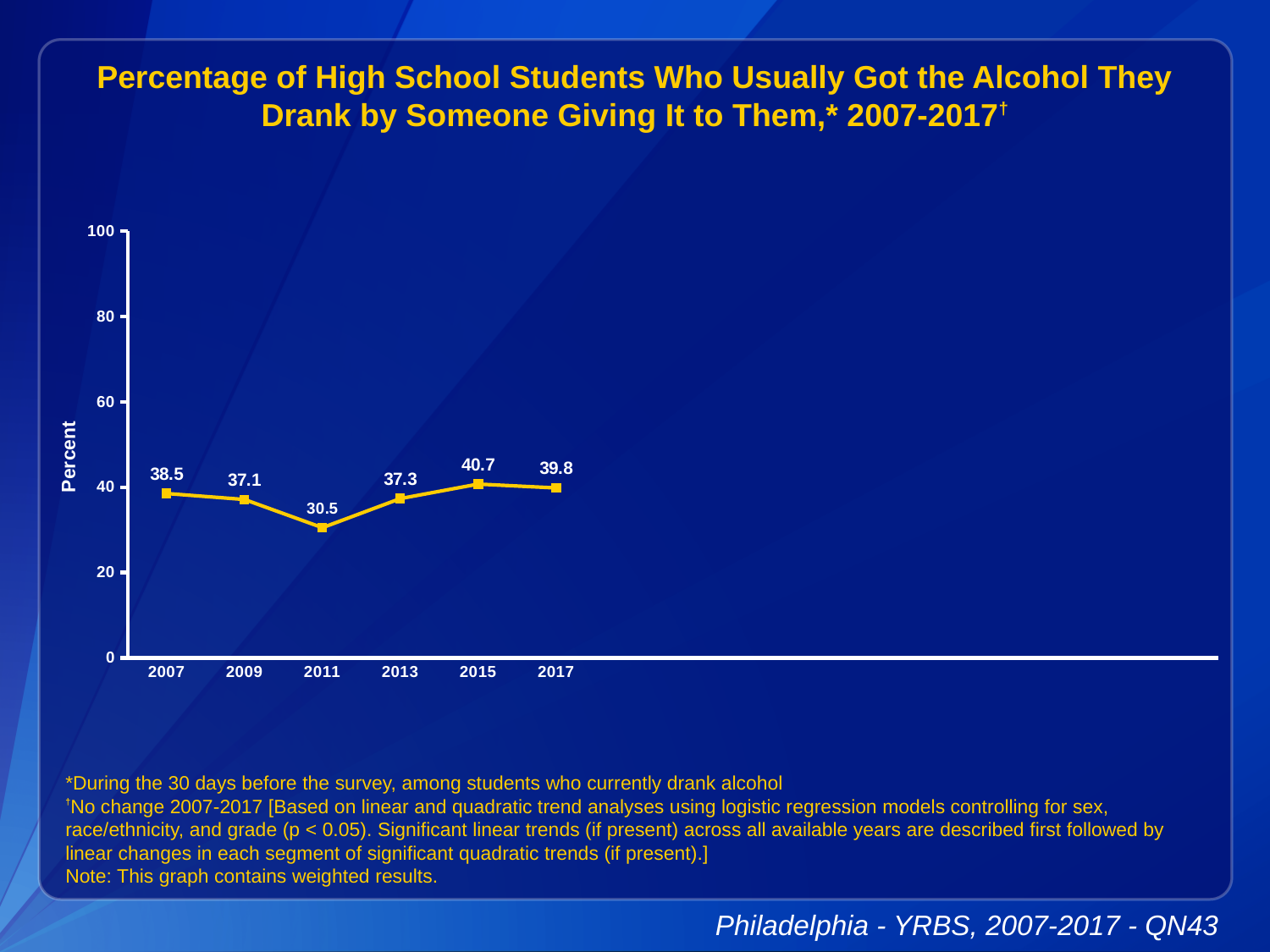
What is the label on the y axis? Percent What is the difference between the 2015 value and the 2011 value? 10.2 What value is plotted for 2017? 39.8 Is the value for 2011 greater or less than 40? less Which year has the lowest value? 2011 What type of chart is shown on the slide? line chart Which is larger, the value for 2009 or the value for 2013? 2013 What value is plotted for 2015? 40.7 How many years are plotted on the chart? 6 What was the percentage of high school students who usually got the alcohol they drank by someone giving it to them in 2007? 38.5 Which year has the highest value? 2015 What value is plotted for 2011? 30.5